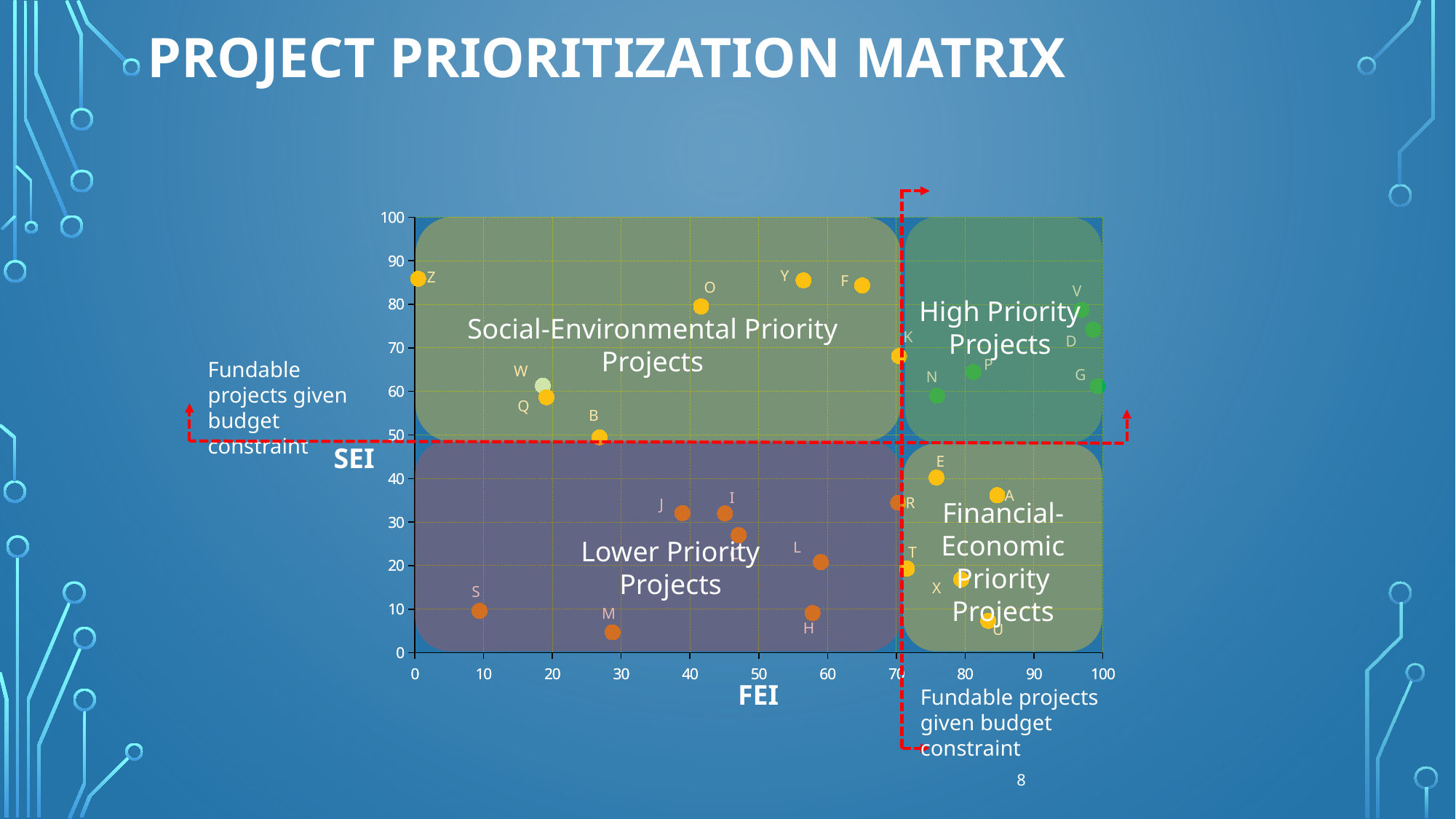
What is the label of the vertical axis of the chart? SEI What is the label of the horizontal axis of the chart? FEI What kind of chart is shown on the slide? scatter chart Is the FEI value for project G greater or less than 90? greater Which project has the lowest FEI value? Z Is the SEI value for project L greater or less than 30? less Is the SEI value for project Z greater or less than 80? greater Which project has a higher SEI value, Z or S? Z